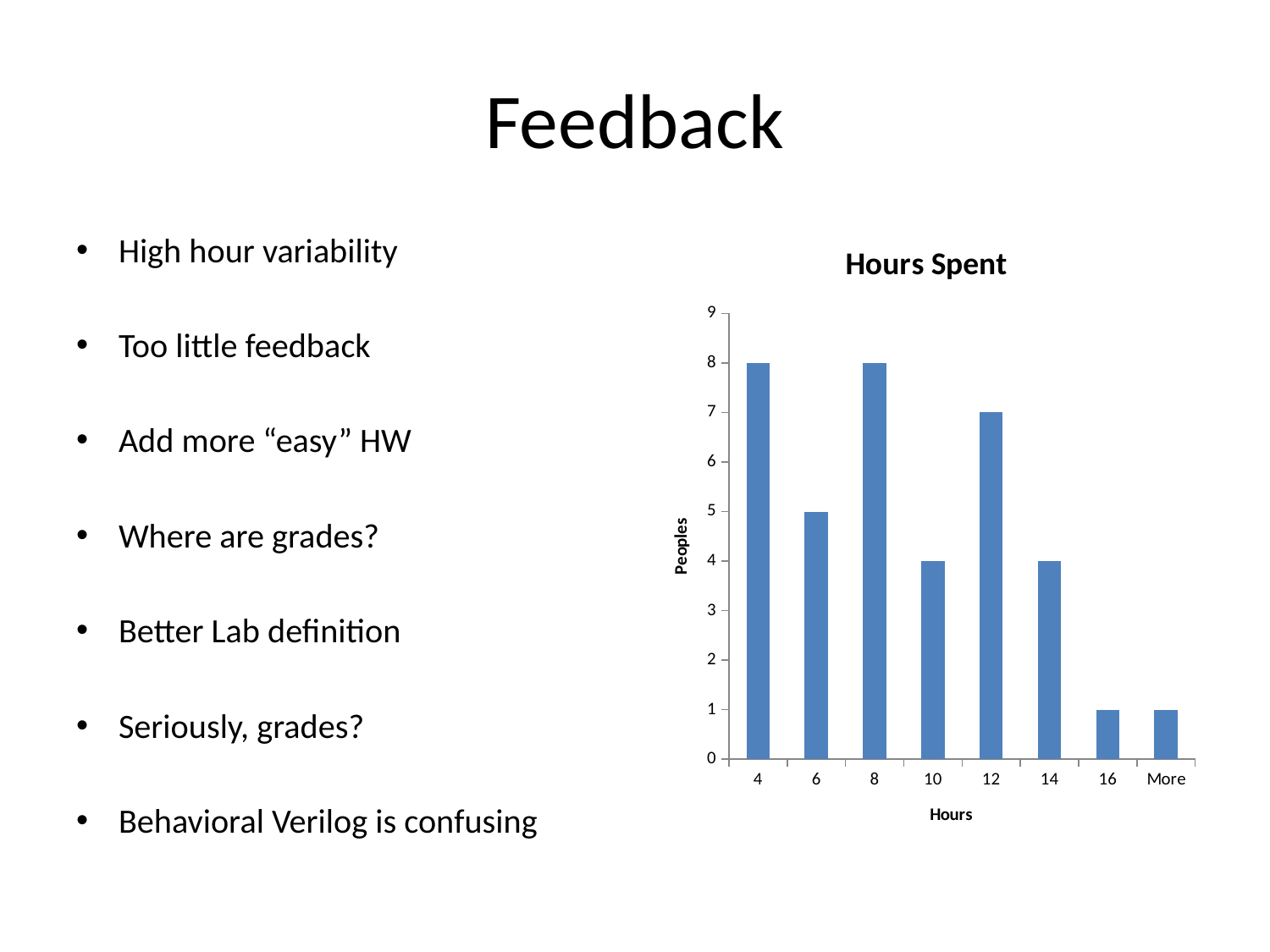
What is the value for 10 hours in the Hours Spent chart? 4 What is the value for 12 hours in the Hours Spent chart? 7 What is the label of the y axis in the Hours Spent chart? Peoples Which has a larger value in the Hours Spent chart, 12 hours or 14 hours? 12 How many categories are shown on the x axis of the Hours Spent chart? 8 What is the value for the 'More' category in the Hours Spent chart? 1 What kind of chart is the Hours Spent chart? bar chart Is the value for 10 hours in the Hours Spent chart greater or less than 5? less What is the title of the chart on the slide? Hours Spent What is the value for 4 hours in the Hours Spent chart? 8 What is the value for 6 hours in the Hours Spent chart? 5 What is the difference between the values for 12 hours and 6 hours in the Hours Spent chart? 2